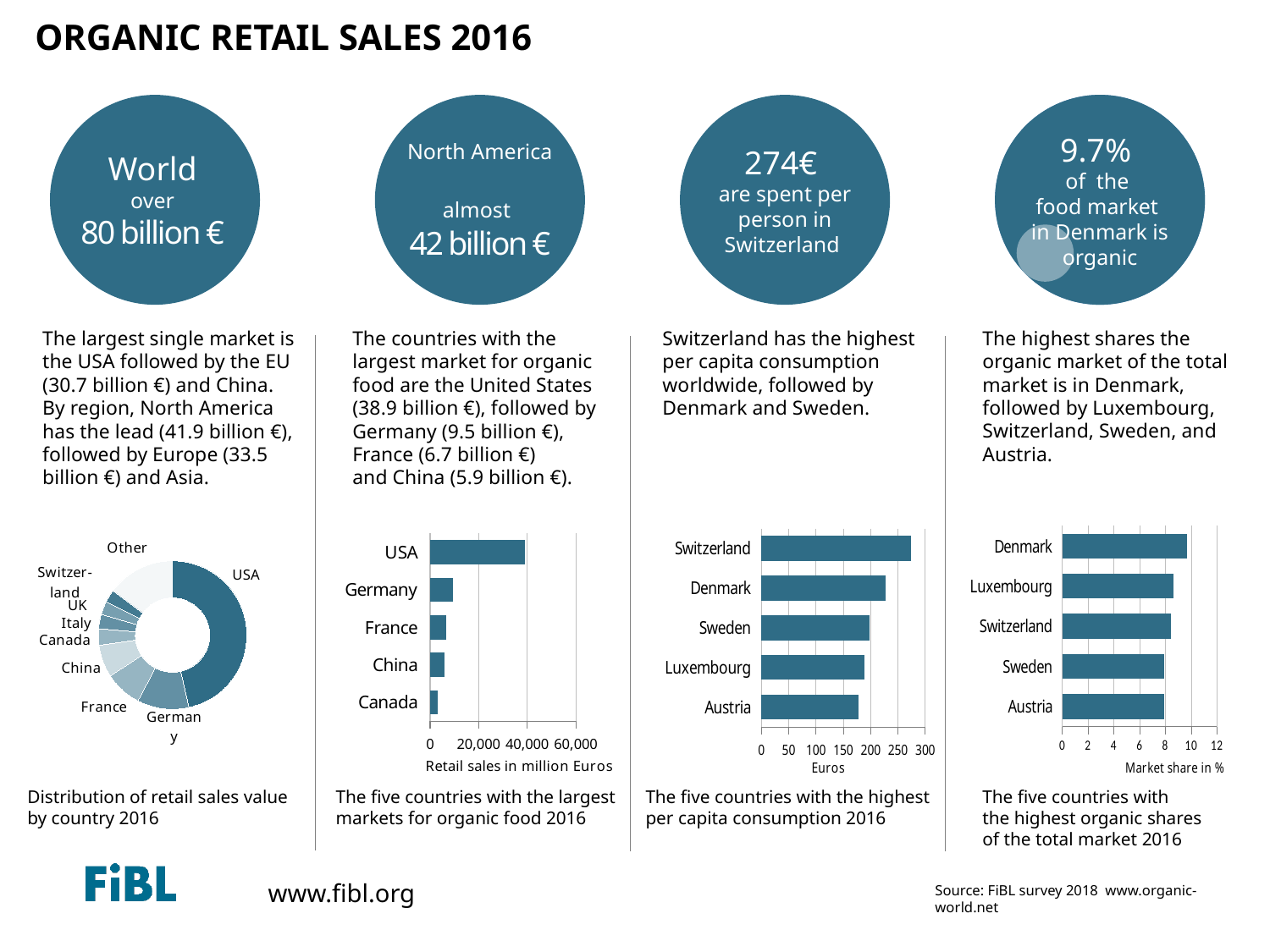
In the chart 'The five countries with the largest markets for organic food 2016', which country has the lowest retail sales? Canada In the chart 'The five countries with the largest markets for organic food 2016', which country has the highest retail sales? USA In the chart 'The five countries with the largest markets for organic food 2016', is the value for USA greater or less than 20,000? greater What kind of chart is 'Distribution of retail sales value by country 2016'? Donut (pie) chart In the chart 'The five countries with the highest per capita consumption 2016', which country has the highest per capita consumption? Switzerland In the chart 'The five countries with the highest per capita consumption 2016', which is larger, the value for Denmark or the value for Luxembourg? Denmark In the chart 'The five countries with the largest markets for organic food 2016', is the value for Germany greater or less than 20,000? less In the chart 'The five countries with the highest per capita consumption 2016', is the value for Switzerland greater or less than 250? greater In the chart 'The five countries with the highest organic shares of the total market 2016', which country has the highest market share? Denmark How many countries are shown in the chart 'The five countries with the highest organic shares of the total market 2016'? 5